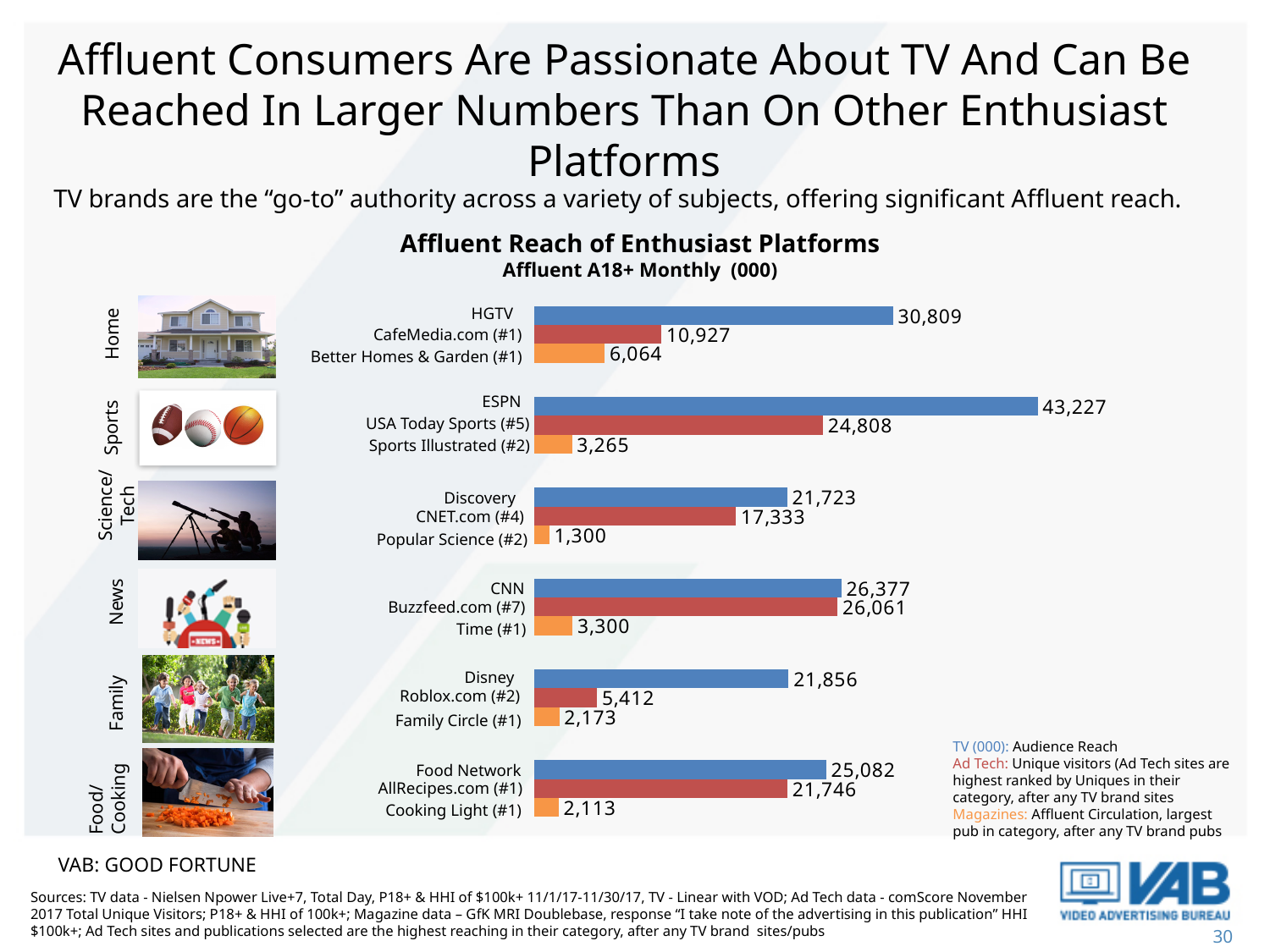
What is the value for Buzzfeed.com (#7)? 26,061 What is the title of the chart? Affluent Reach of Enthusiast Platforms What is the value for Popular Science (#2)? 1,300 How many bars are plotted on the chart? 18 What kind of chart is shown on the slide? Bar chart What is the difference between the values for CNN and Buzzfeed.com (#7)? 316 What is the value for HGTV? 30,809 Which platform has the highest value on the chart? ESPN What is the value for ESPN? 43,227 What is the difference between the values for Food Network and AllRecipes.com (#1)? 3,336 Which has a larger value, USA Today Sports (#5) or CNET.com (#4)? USA Today Sports (#5) Which platform has the lowest value on the chart? Popular Science (#2)